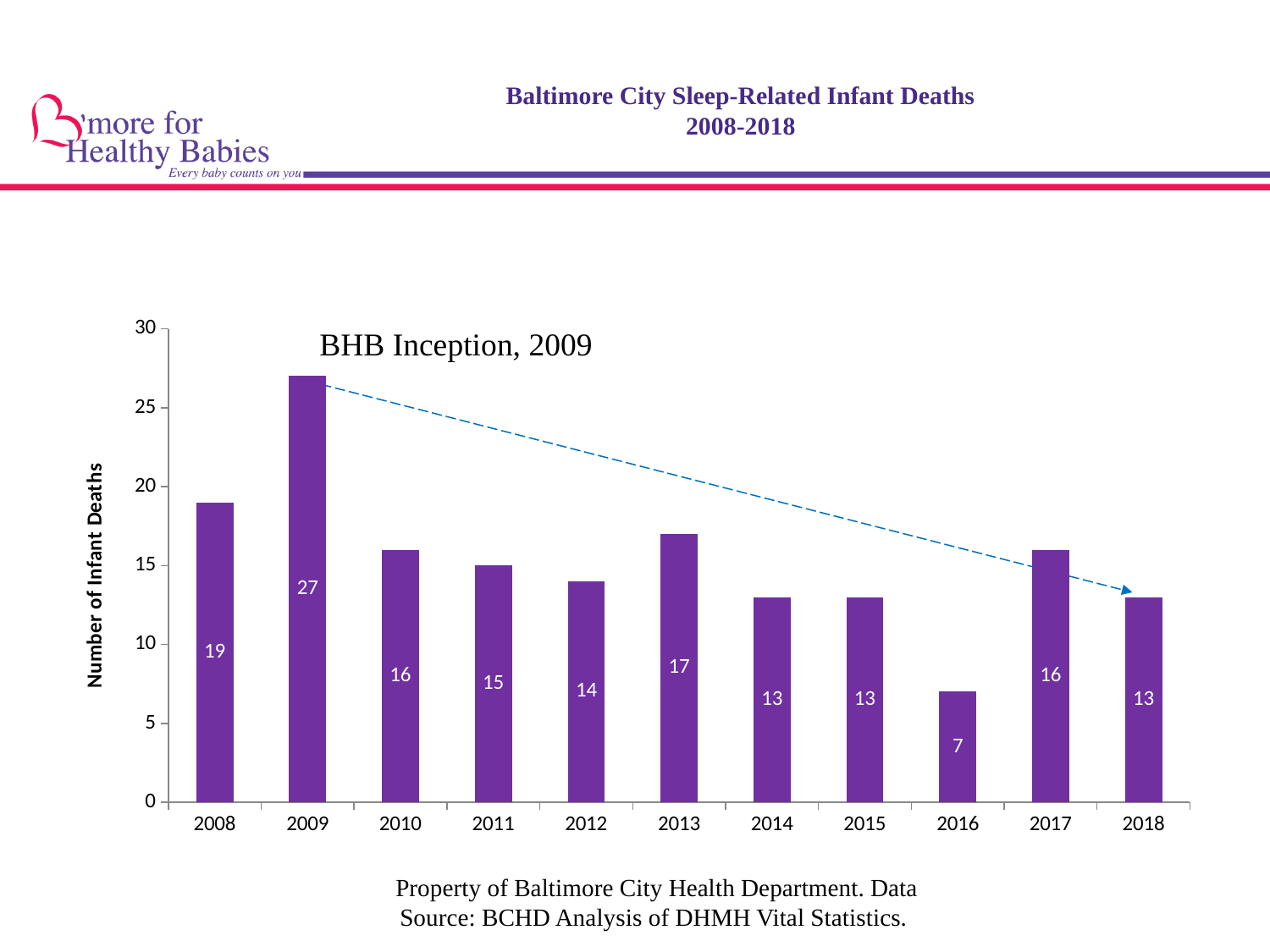
What is the difference in infant deaths between 2009 and 2018? 14 Which year has the highest number of infant deaths? 2009 Which year has the lowest number of infant deaths? 2016 What is the y-axis label of the chart? Number of Infant Deaths What kind of chart is shown on the slide? bar chart Which year had more infant deaths, 2013 or 2012? 2013 What is the value for 2018? 13 What is the number of infant deaths shown for 2016? 7 How many years are shown on the x axis? 11 Is the value for 2008 greater or less than 15? greater How many sleep-related infant deaths were recorded in 2009? 27 What is the difference between the 2008 and 2016 values? 12